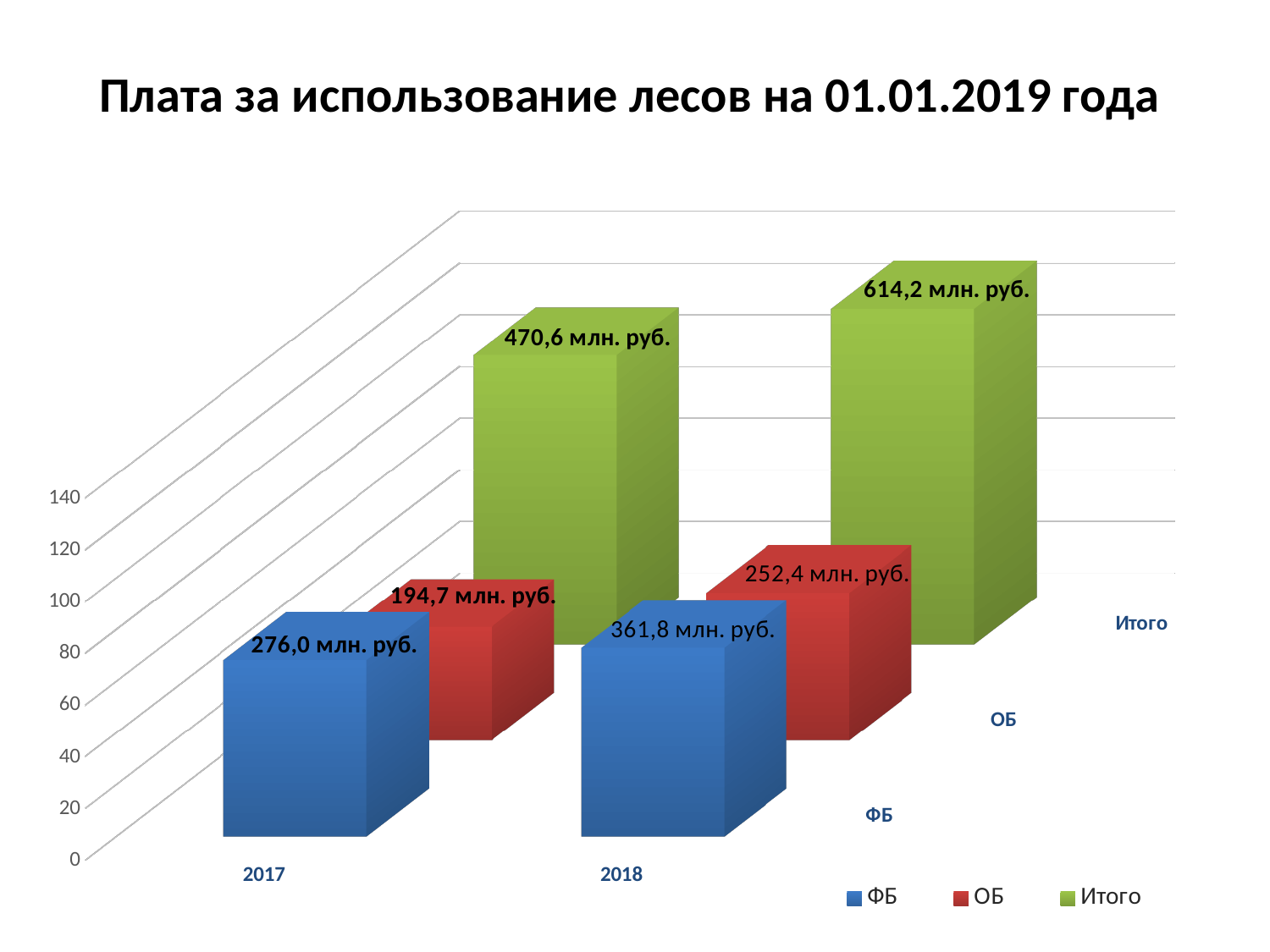
What is the value for ФБ in 2018? 361,8 млн. руб. Which is larger: ОБ in 2017 or ОБ in 2018? ОБ in 2018 What is the value for ОБ in 2018? 252,4 млн. руб. What is the difference between the ФБ values for 2018 and 2017? 85,8 млн. руб. What kind of chart is shown on the slide? Bar chart What is the difference between the Итого values for 2018 and 2017? 143,6 млн. руб. What is the title of the chart? Плата за использование лесов на 01.01.2019 года Which series has the lowest value in 2017? ОБ Which year has the higher Итого value? 2018 What is the value for ФБ in 2017? 276,0 млн. руб. How many series does the legend list? 3 What is the value for Итого in 2017? 470,6 млн. руб.